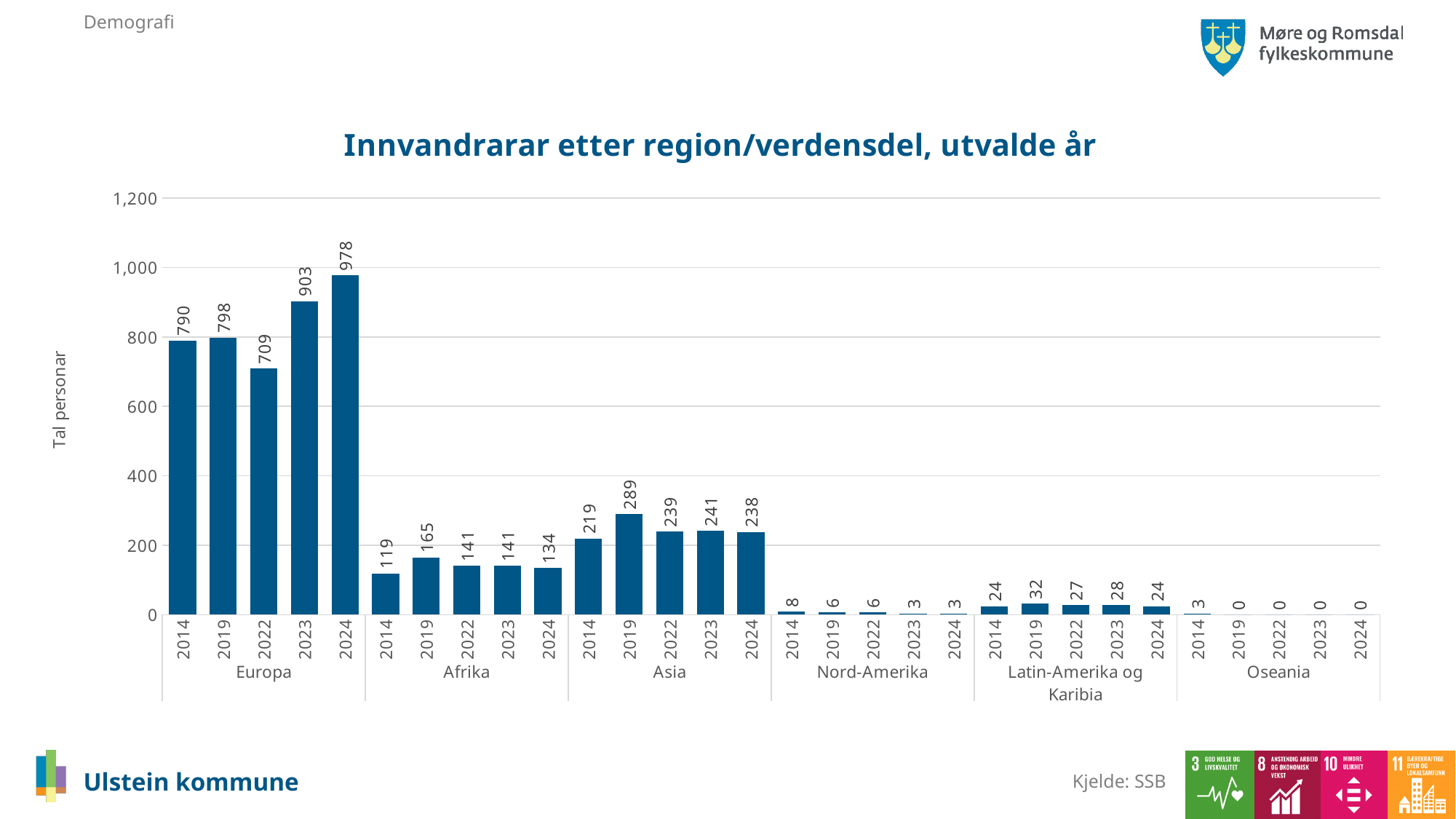
What is the value for Latin-Amerika og Karibia in 2019? 32 Which region has the highest bar in the chart? Europa What kind of chart is this? bar chart Which year has the lowest value within the Europa group? 2022 How many regions are shown on the x axis? 6 Which is larger: Afrika in 2019 or Asia in 2014? Asia in 2014 What is the value for Asia in 2019? 289 What is the value for Afrika in 2014? 119 What is the value for Europa in 2024? 978 Is the value for Europa in 2023 greater or less than 800? greater What is the title of the chart? Innvandrarar etter region/verdensdel, utvalde år What is the difference between the Europa values for 2024 and 2023? 75